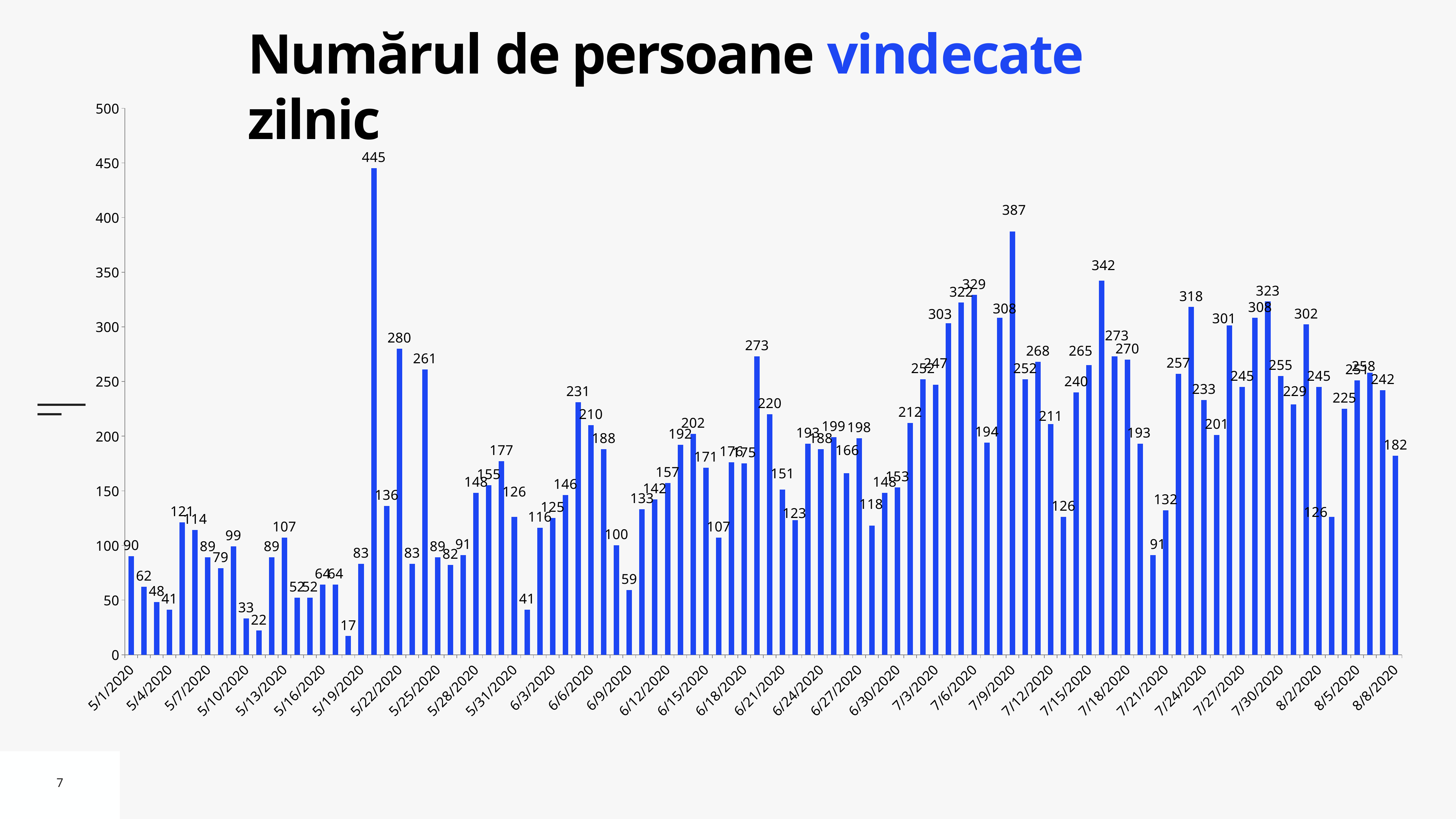
What is the value for 5/1/2020? 90 Is the value for 7/9/2020 greater or less than 350? greater Which is larger, the value for 7/9/2020 or the value for 7/6/2020? 7/9/2020 What is the title of the chart? Numărul de persoane vindecate zilnic What is the highest value shown in the chart? 445 Which date has the lowest number of recovered persons? 5/18/2020 What is the difference between the highest value (445) and the value for 7/9/2020 (387)? 58 Which date has the highest number of recovered persons? 5/20/2020 What is the value for 8/8/2020? 182 What type of chart is shown on the slide? Bar chart What is the value for 7/9/2020? 387 What is the value for 6/9/2020? 59